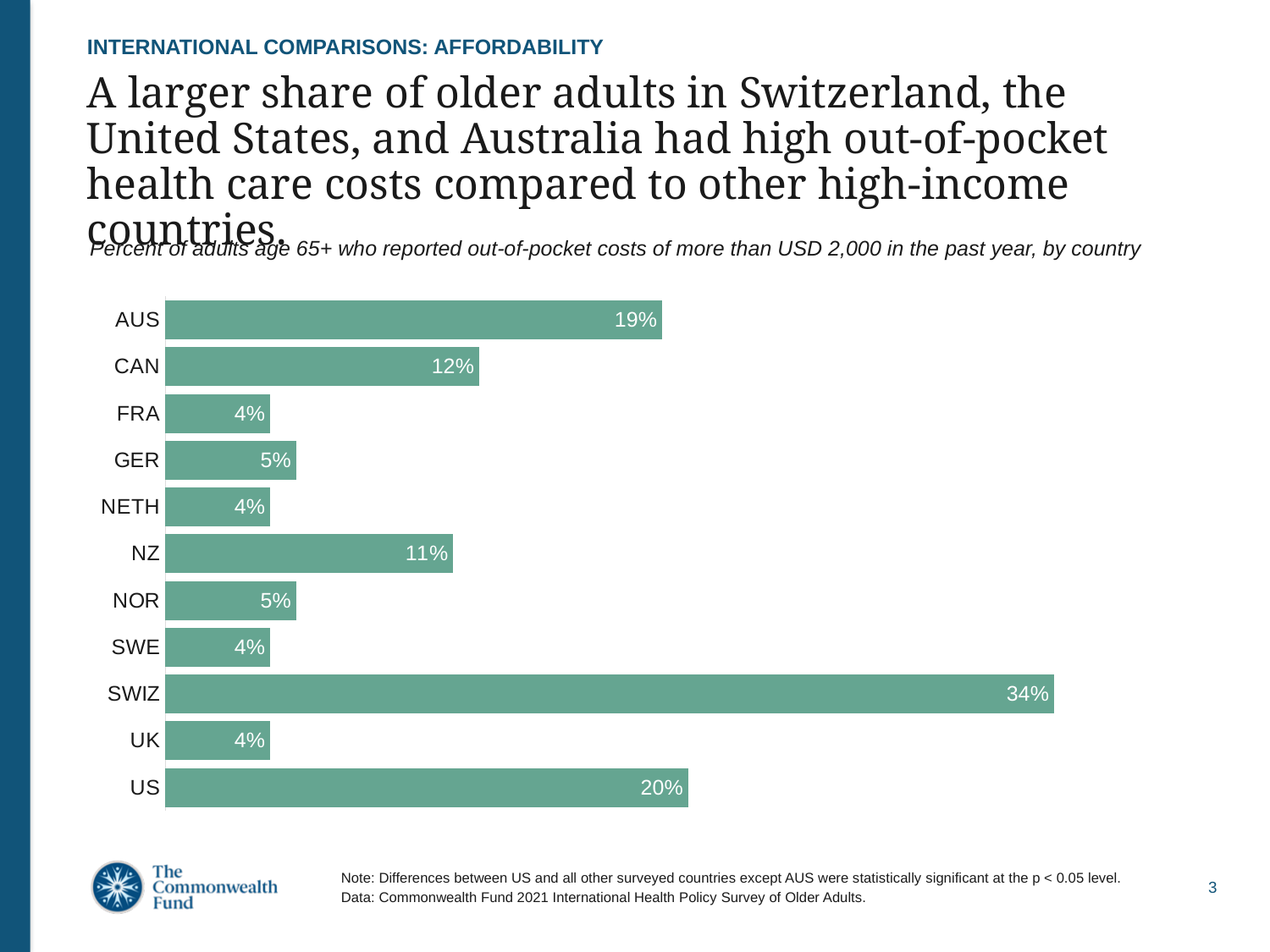
What is the difference between the values for AUS and CAN? 7% What is the value for SWIZ? 34% Which is larger, the value for US or the value for AUS? US What is the value for NZ? 11% What is the difference between the values for SWIZ and US? 14% How many countries are shown in the chart? 11 Which is larger, the value for CAN or the value for NZ? CAN What is the value for CAN? 12% Which country has the highest value? SWIZ What kind of chart is shown on the slide? bar chart What is the value for UK? 4% What is the value for GER? 5%